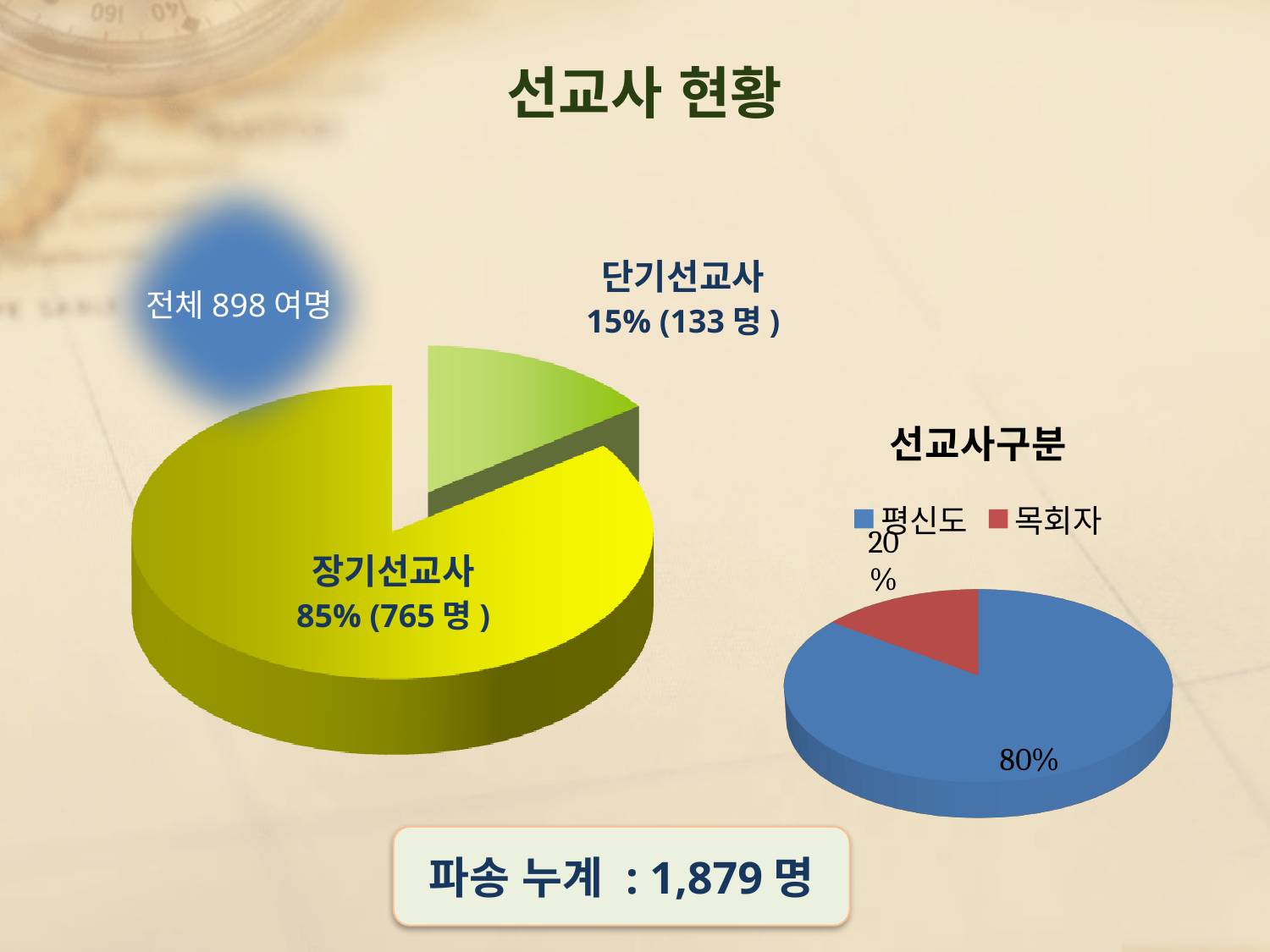
In the left pie chart, which slice is the smallest? 단기선교사 What kind of chart is the chart titled 선교사구분? pie chart In the left pie chart, what share is labelled for 장기선교사? 85% In the left pie chart, which slice is the largest? 장기선교사 In the left pie chart, how many slices are there? 2 In the left pie chart, what is the difference in percentage points between 장기선교사 and 단기선교사? 70 In the chart titled 선교사구분, which category is larger, 평신도 or 목회자? 평신도 In the left pie chart, how many people (명) are shown for 장기선교사? 765 명 In the chart titled 선교사구분, what share is shown for 목회자? 20% In the chart titled 선교사구분, what share is shown for 평신도? 80% In the left pie chart, how many people (명) are shown for 단기선교사? 133 명 How many entries does the legend of the chart titled 선교사구분 list? 2